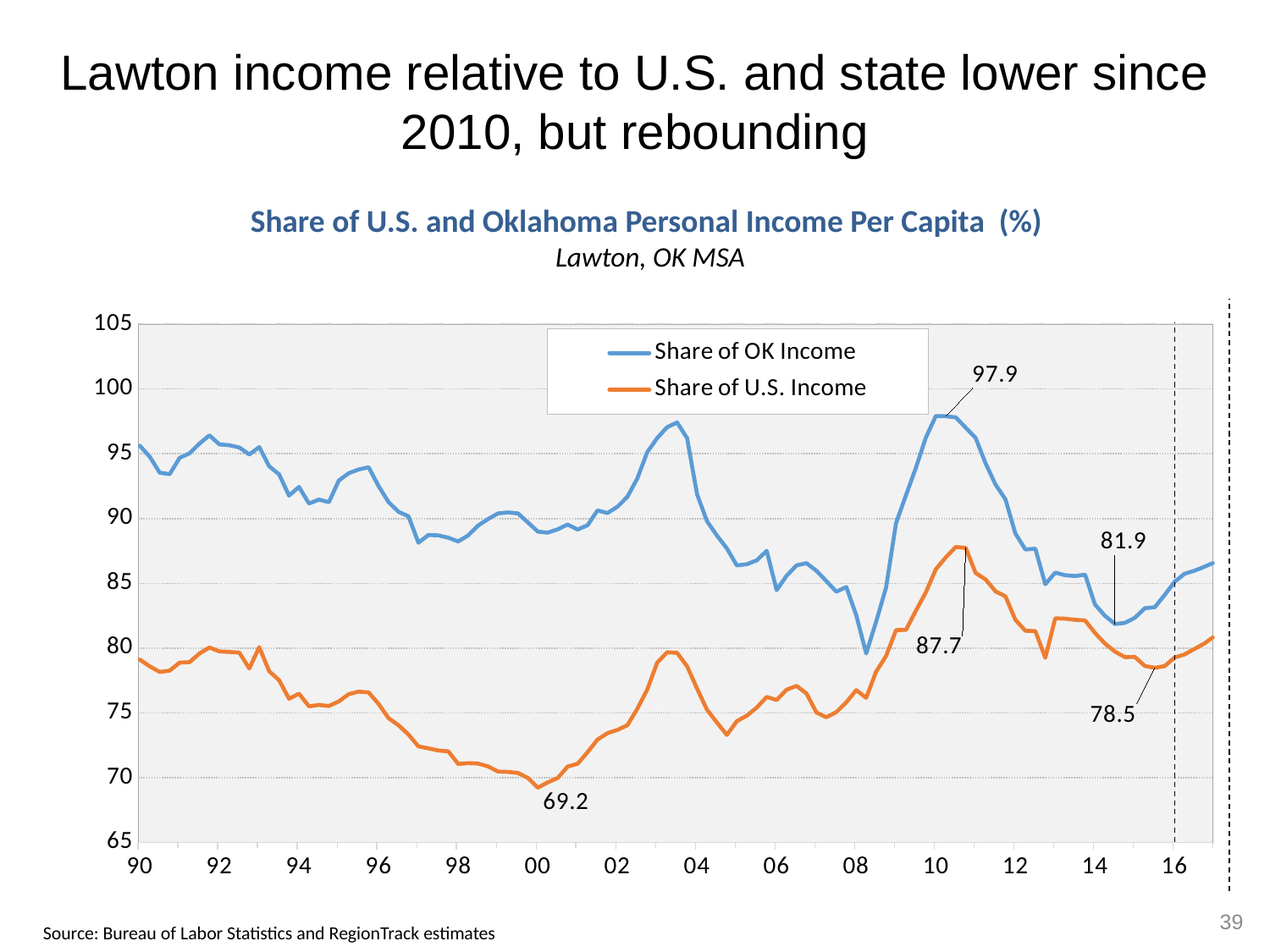
What kind of chart is shown on the slide? line chart What is the labeled low value of the Share of U.S. Income series around 2000? 69.2 Does the Share of U.S. Income series rise or fall from 1990 to 2000? fall Is the value of Share of U.S. Income in 1990 greater or less than 75? greater What is the difference between the labeled lows of 81.9 (Share of OK Income) and 78.5 (Share of U.S. Income)? 3.4 What is the difference between the labeled 2010 peaks of the Share of OK Income (97.9) and Share of U.S. Income (87.7) series? 10.2 What is the title of the chart? Share of U.S. and Oklahoma Personal Income Per Capita (%) What is the labeled peak value of the Share of OK Income series around 2010? 97.9 What is the labeled peak value of the Share of U.S. Income series around 2010-2011? 87.7 What is the labeled low value of the Share of OK Income series around 2014-2015? 81.9 Which series stays higher throughout the chart, Share of OK Income or Share of U.S. Income? Share of OK Income How many series does the legend list? 2